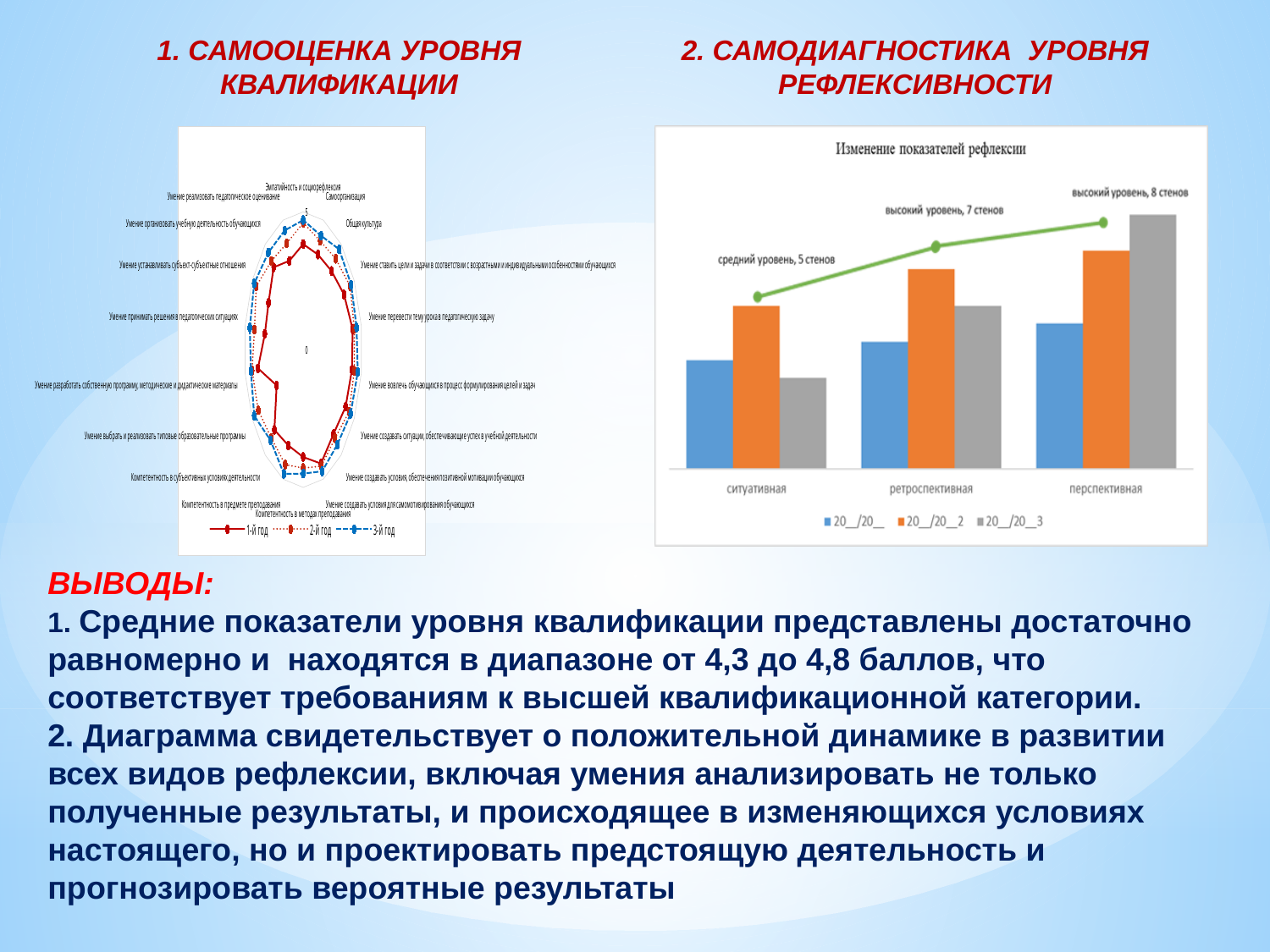
In the right-hand chart "Изменение показателей рефлексии", for the category "ситуативная", which bar is taller: the orange (20__/20__2) or the grey (20__/20__3)? orange (20__/20__2) What is the title of the right-hand chart? Изменение показателей рефлексии What type of chart is the right-hand chart titled "Изменение показателей рефлексии"? bar chart In the right-hand chart "Изменение показателей рефлексии", does the line rise or fall from "ситуативная" to "перспективная"? rises In the right-hand chart "Изменение показателей рефлексии", how many стенов are labelled on the line for the category "ретроспективная"? 7 стенов In the right-hand chart "Изменение показателей рефлексии", how many стенов are labelled on the line for the category "перспективная"? 8 стенов In the right-hand chart "Изменение показателей рефлексии", for which category is the grey bar (20__/20__3) the tallest? перспективная How many series does the legend of the right-hand chart "Изменение показателей рефлексии" list? 3 How many categories are shown on the x axis of the right-hand chart "Изменение показателей рефлексии"? 3 What type of chart is the left-hand chart under "1. САМООЦЕНКА УРОВНЯ КВАЛИФИКАЦИИ"? radar chart In the right-hand chart "Изменение показателей рефлексии", what level is labelled on the line for the category "ситуативная"? средний уровень, 5 стенов In the right-hand chart "Изменение показателей рефлексии", what is the difference in стенов between the line values for "перспективная" and "ситуативная"? 3 стенов